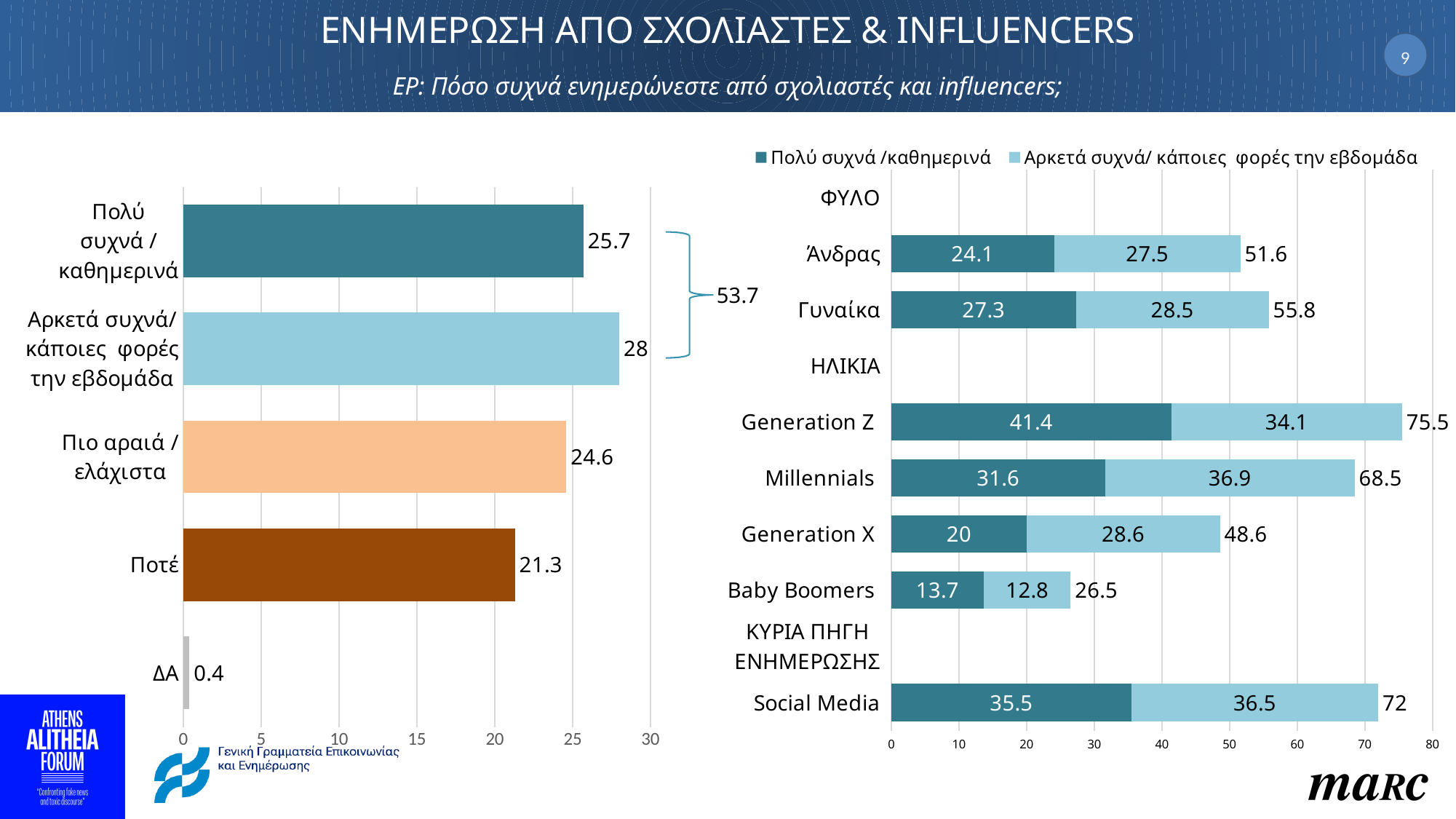
In the right stacked bar chart, what is the difference between the Αρκετά συχνά/ κάποιες φορές την εβδομάδα values for Social Media and Generation X? 7.9 In the right stacked bar chart, which category has the lowest total? Baby Boomers What kind of chart is the chart on the left of the slide? Bar chart In the right stacked bar chart, what is the total for Millennials? 68.5 In the left bar chart, how many categories are shown? 5 In the left bar chart, what is the value for Ποτέ? 21.3 In the right stacked bar chart, what is the Πολύ συχνά /καθημερινά value for Generation Z? 41.4 In the left bar chart, what is the difference between the values for Αρκετά συχνά/ κάποιες φορές την εβδομάδα and Πιο αραιά / ελάχιστα? 3.4 How many series does the legend of the right stacked bar chart list? 2 In the left bar chart, which category has the lowest value? ΔΑ In the right stacked bar chart, which is larger: the total for Άνδρας or the total for Γυναίκα? Γυναίκα In the left bar chart, which category has the highest value? Αρκετά συχνά/ κάποιες φορές την εβδομάδα